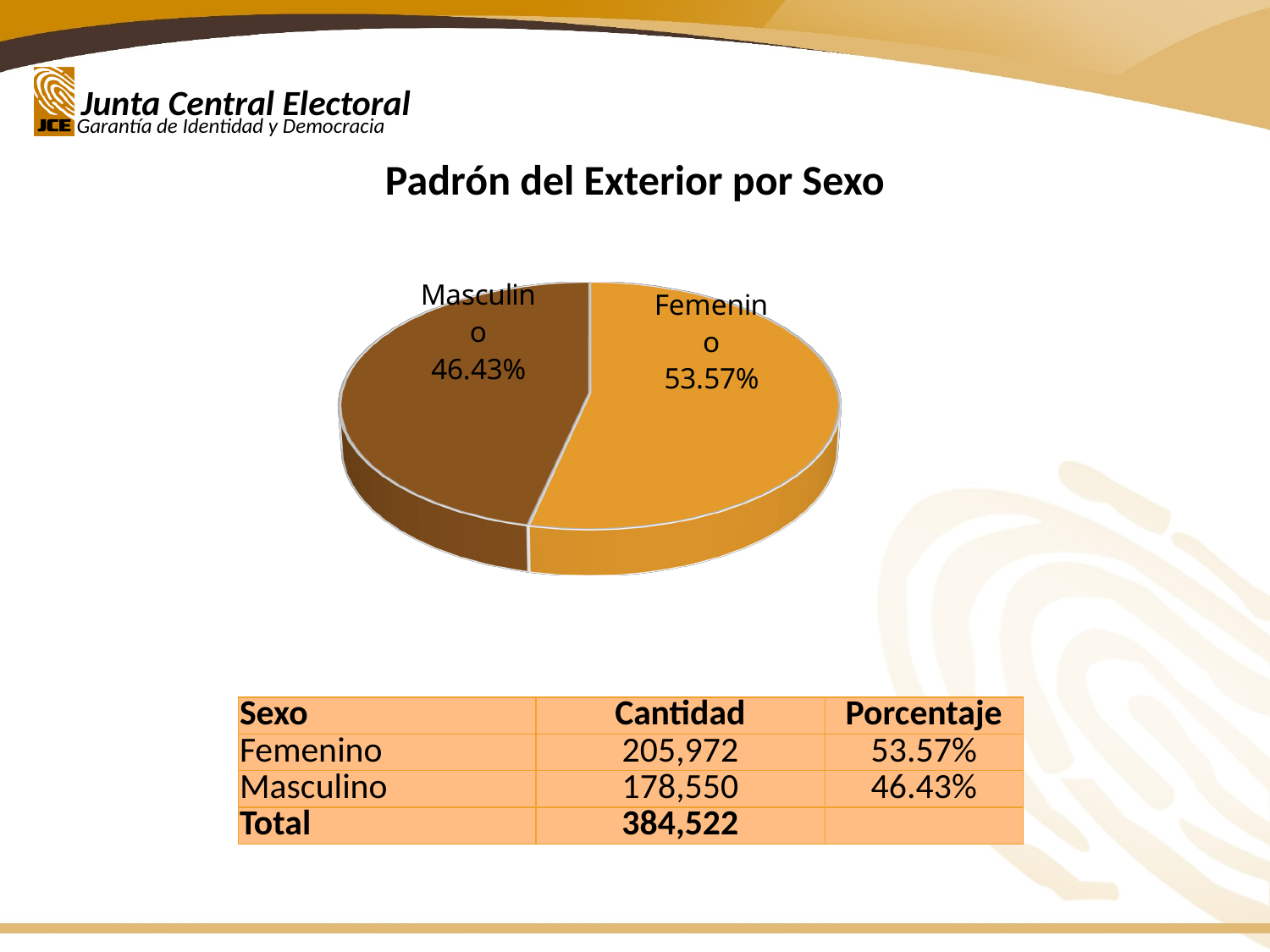
How many slices does the pie chart have? 2 Which category has the largest slice of the pie? Femenino Which category has the smallest slice of the pie? Masculino Which slice is shown in the darker brown colour? Masculino What share of the pie does the Femenino slice represent? 53.57% What share of the pie does the Masculino slice represent? 46.43% Is the Masculino share of the pie greater or less than 50%? less What kind of chart is shown on the slide? Pie chart What is the difference in percentage points between the Femenino and Masculino slices? 7.14 Which slice is larger, Femenino or Masculino? Femenino What is the title of the slide's chart? Padrón del Exterior por Sexo